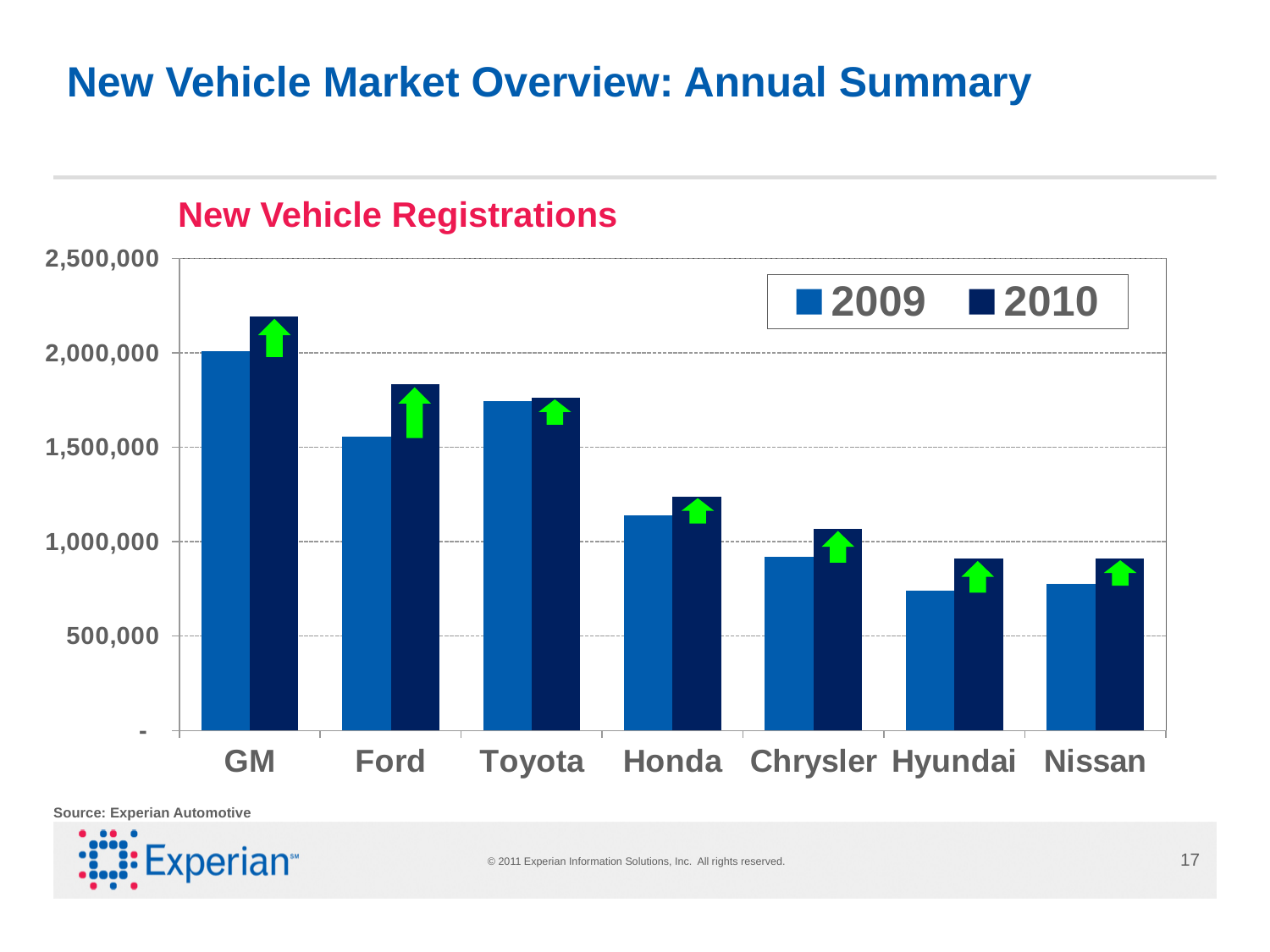
What kind of chart is shown on the slide? Bar chart Which manufacturer has the highest 2010 new vehicle registrations? GM What is the title of the chart? New Vehicle Registrations Is the 2009 value for Hyundai greater or less than 1,000,000? less Is the 2010 value for Chrysler greater or less than 1,000,000? greater Is the 2009 value for Chrysler greater or less than 1,000,000? less Which is larger, the 2010 value for Honda or the 2010 value for Chrysler? Honda How many manufacturers are shown on the x axis? 7 How many series does the legend list? 2 Which is larger, the 2009 value for Ford or the 2009 value for Toyota? Toyota